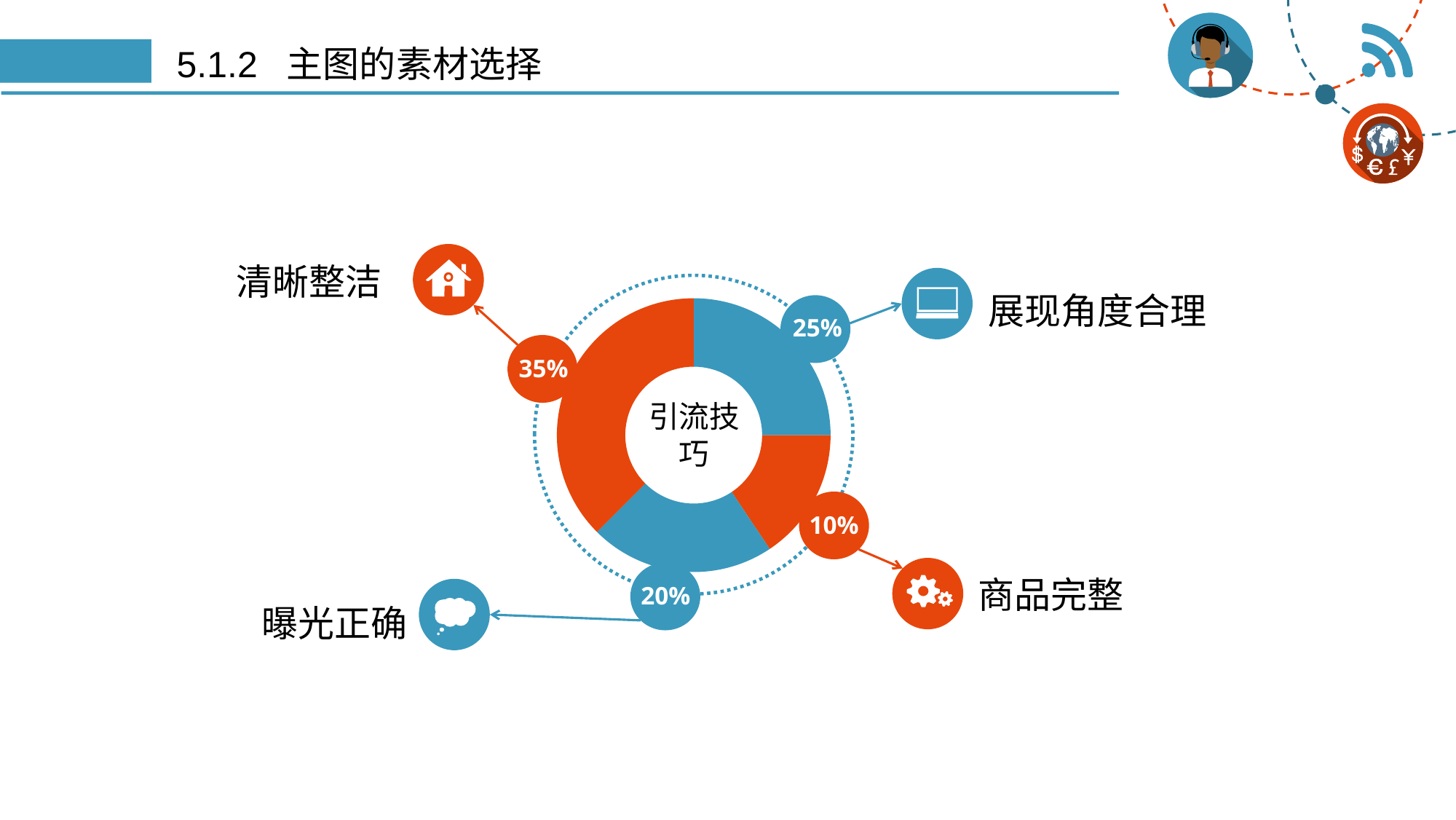
How many categories are labelled around the donut chart? 4 What percentage is shown for 清晰整洁? 35% Which is larger, the percentage for 展现角度合理 or for 曝光正确? 展现角度合理 Which category has the smallest percentage? 商品完整 What is the difference between the percentages for 展现角度合理 and 曝光正确? 5% What is the difference between the percentages for 清晰整洁 and 商品完整? 25% Which category has the largest percentage? 清晰整洁 What percentage is shown for 展现角度合理? 25% What text appears in the centre of the donut chart? 引流技巧 What percentage is shown for 商品完整? 10% What kind of chart is shown on the slide? Donut (pie) chart What percentage is shown for 曝光正确? 20%